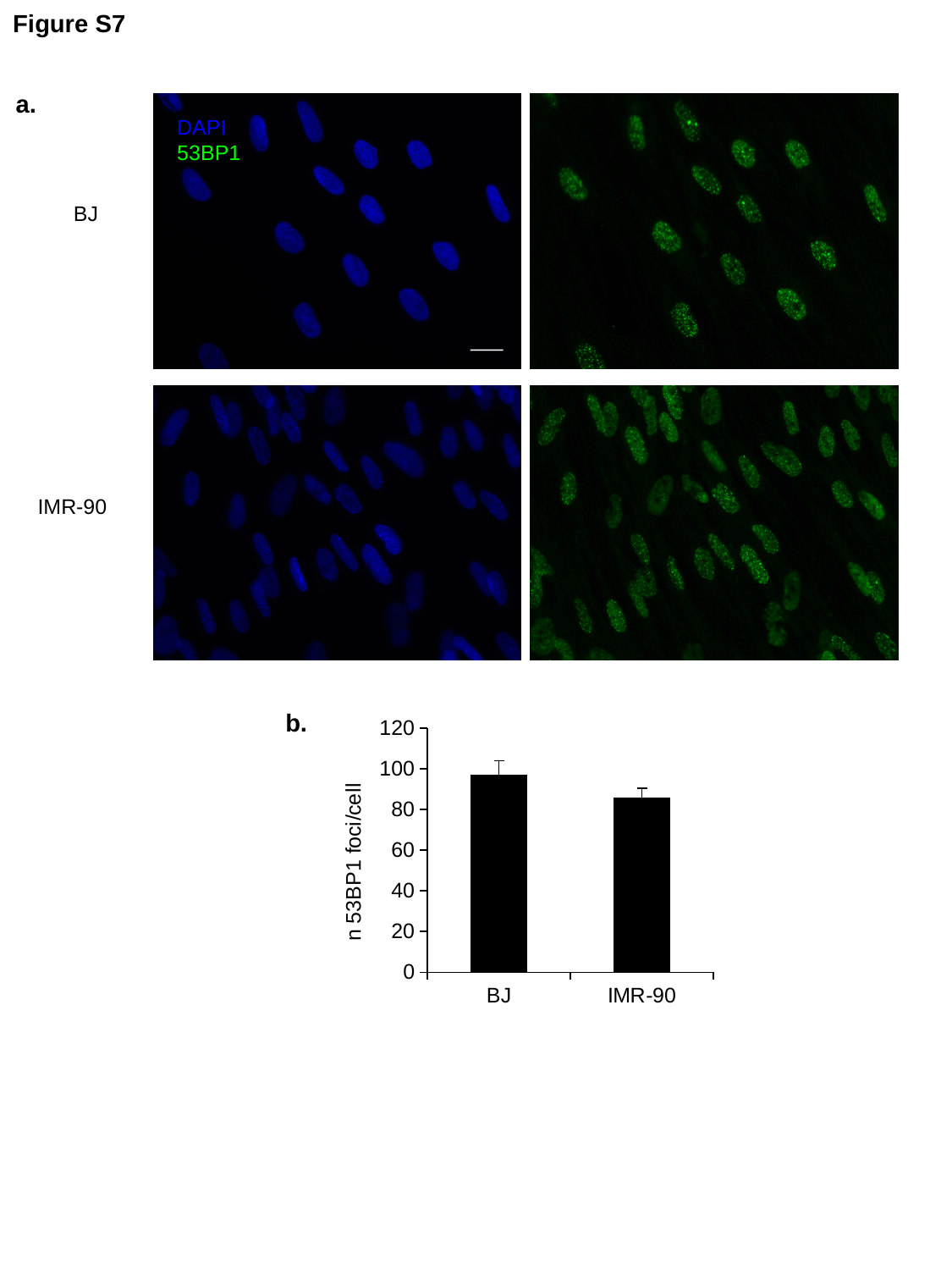
In the chart in panel b, is the value for BJ larger or smaller than the value for IMR-90? larger In the chart in panel b, is the value for BJ greater or less than 120? less How many categories are plotted on the x axis of the chart in panel b? 2 What is the highest tick value shown on the y axis of the chart in panel b? 120 In the chart in panel b, which category has the highest number of 53BP1 foci per cell? BJ What is the y-axis label of the chart in panel b? n 53BP1 foci/cell In the chart in panel b, is the value for BJ greater or less than 80? greater What kind of chart is shown in panel b? bar chart In the chart in panel b, is the value for IMR-90 greater or less than 100? less In the chart in panel b, which category has the lowest number of 53BP1 foci per cell? IMR-90